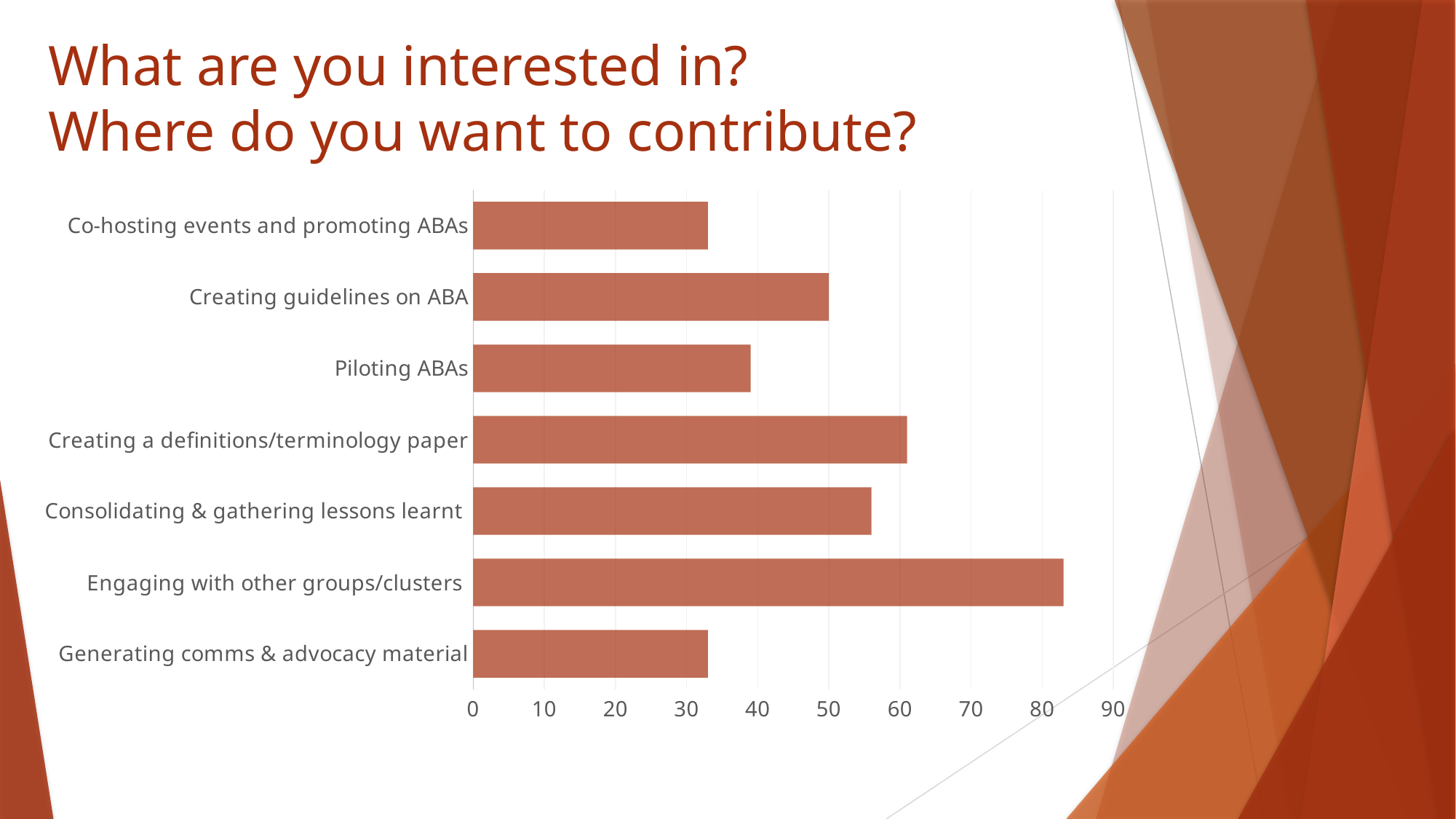
What is the value for Creating guidelines on ABA? 50 What kind of chart is shown on the slide? bar chart Is the value for Engaging with other groups/clusters greater or less than 80? greater What is the title of the slide containing the chart? What are you interested in? Where do you want to contribute? Which is larger: the value for Creating a definitions/terminology paper or the value for Consolidating & gathering lessons learnt? Creating a definitions/terminology paper Is the value for Consolidating & gathering lessons learnt greater or less than 50? greater Is the value for Generating comms & advocacy material greater or less than 40? less How many categories are plotted in the chart? 7 Which category has the highest value? Engaging with other groups/clusters Which is larger: the value for Piloting ABAs or the value for Co-hosting events and promoting ABAs? Piloting ABAs